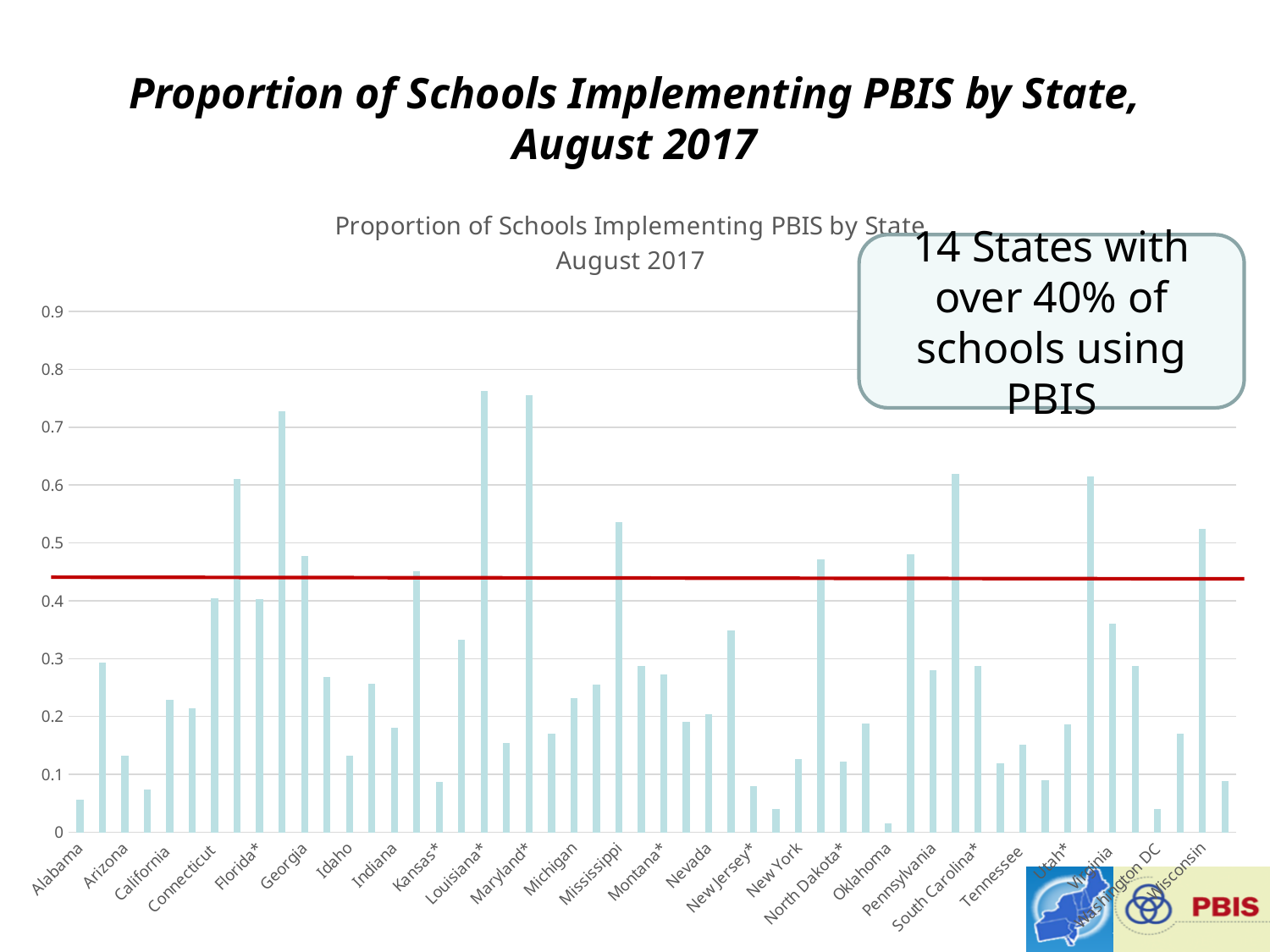
How many state names are printed as labels along the horizontal axis of the chart? 26 What is the highest value shown on the vertical axis of the chart? 0.9 Is the tallest bar in the chart greater or less than 0.8? less Is the tallest bar in the chart greater or less than 0.7? greater Is the value for Alabama greater or less than 0.1? less Which state is labeled first (leftmost) on the horizontal axis? Alabama What kind of chart is shown on the slide? bar chart Is the value for Alabama greater or less than the value for Arizona? less According to the callout on the slide, how many states have over 40% of schools using PBIS? 14